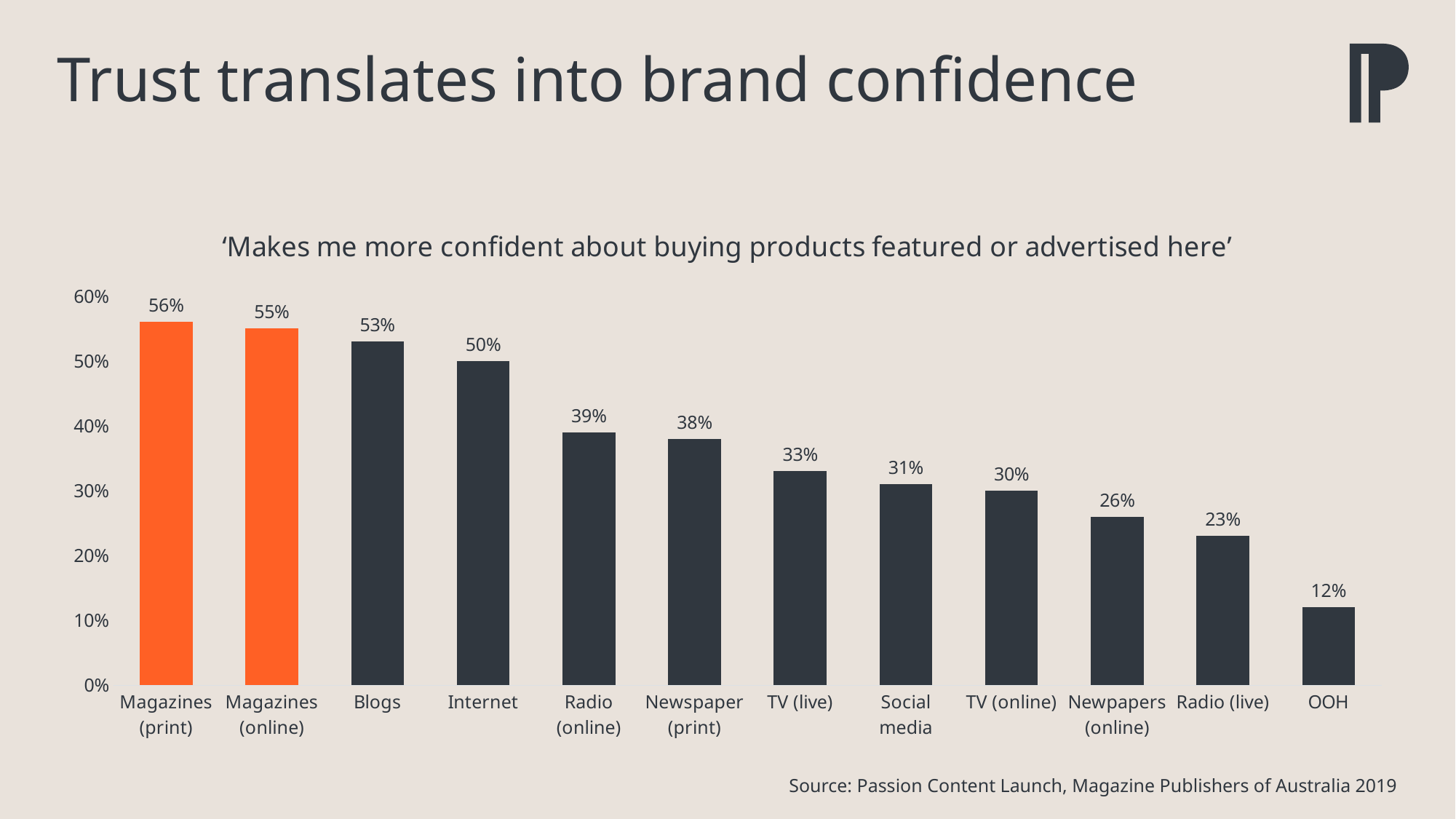
Which category has the highest value? Magazines (print) Which two bars are highlighted in orange? Magazines (print) and Magazines (online) What is the value for Radio (live)? 23% What kind of chart is shown on the slide? bar chart Is the value for Newspaper (print) greater or less than 40%? less What is the difference between the values for Magazines (print) and Internet? 6% Which is larger, the value for Radio (online) or the value for TV (online)? Radio (online) Which category has the lowest value? OOH What is the value for Blogs? 53% What is the value for Social media? 31% What is the difference between the values for TV (live) and OOH? 21% How many categories are shown on the chart? 12